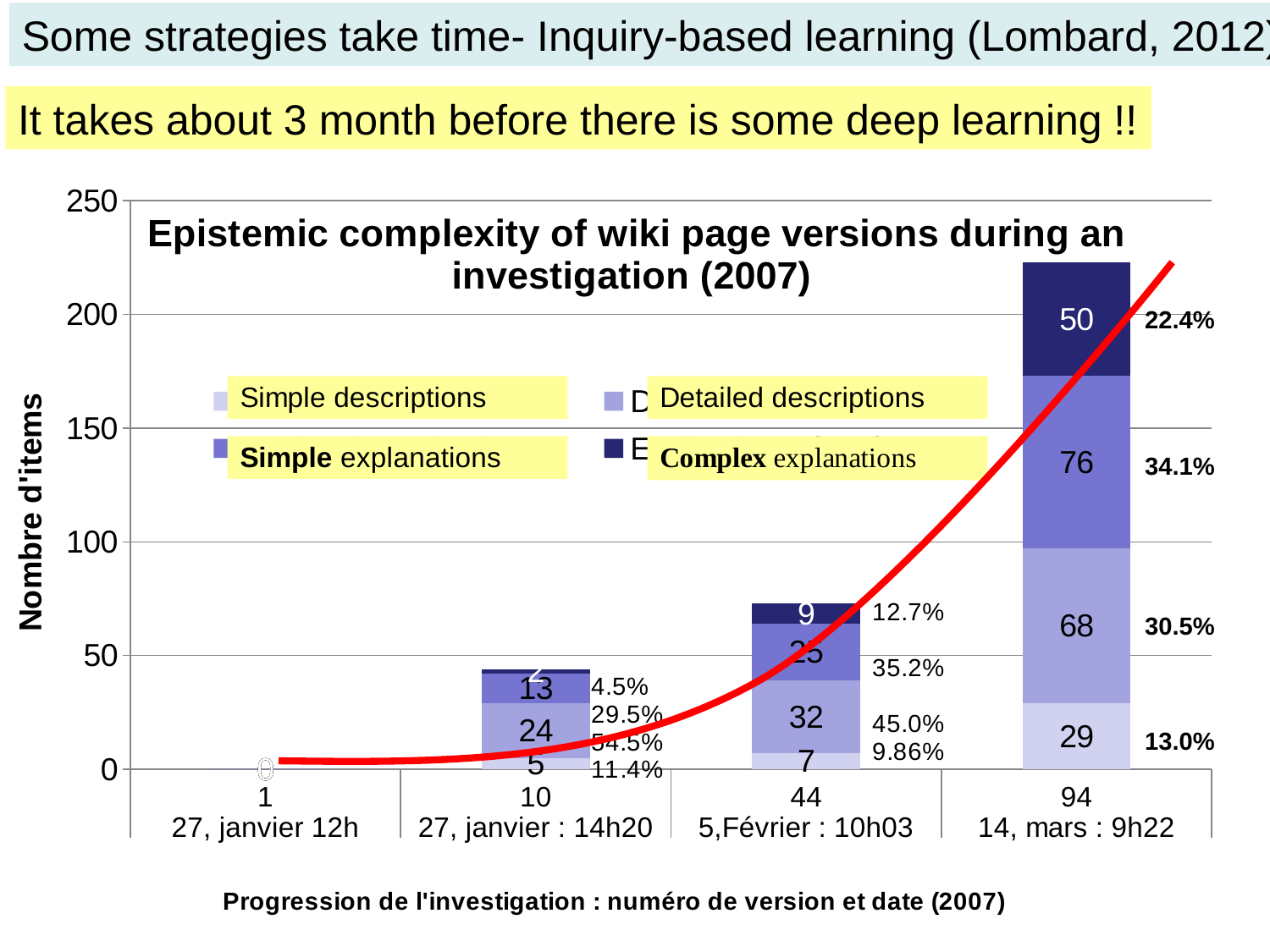
How many series does the legend list? 4 What is the value for Complex explanations at version 44 (5, Février : 10h03)? 9 How many version categories are shown on the x axis? 4 What is the title of the chart? Epistemic complexity of wiki page versions during an investigation (2007) What is the difference between Simple explanations at version 94 and at version 44? 51 What is the value for Simple explanations at version 94 (14, mars : 9h22)? 76 What is the total number of items in the stacked bar for version 94? 223 Which version has the highest total number of items? 94 What is the value for Detailed descriptions at version 10 (27, janvier : 14h20)? 24 What is the total number of items in the stacked bar for version 44? 73 What type of chart is shown on the slide? Stacked bar chart What percentage share do Complex explanations represent at version 94? 22.4%